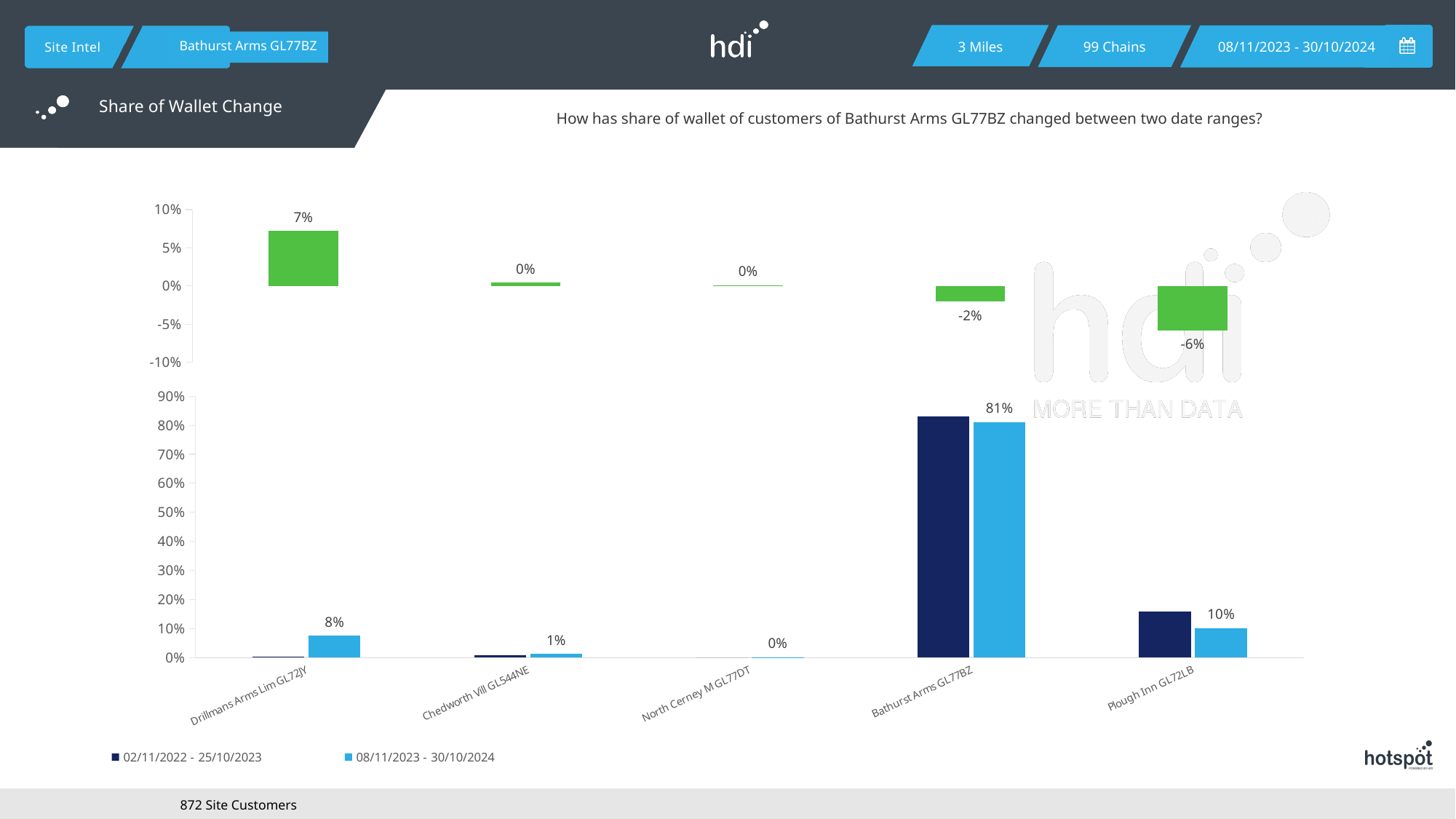
In the bottom chart, which is larger for Plough Inn GL72LB: the 02/11/2022 - 25/10/2023 value or the 08/11/2023 - 30/10/2024 value? 02/11/2022 - 25/10/2023 In the top chart, which site has the highest share of wallet change? Drillmans Arms Lim GL72JY How many series does the legend of the bottom chart list? 2 In the bottom chart, what is the share of wallet for Bathurst Arms GL77BZ in the 08/11/2023 - 30/10/2024 period? 81% In the bottom chart, what is the share of wallet for Plough Inn GL72LB in the 08/11/2023 - 30/10/2024 period? 10% In the top chart, what is the share of wallet change for Plough Inn GL72LB? -6% In the bottom chart, is the 02/11/2022 - 25/10/2023 value for Bathurst Arms GL77BZ greater or less than 80%? greater In the top chart, what is the share of wallet change for Drillmans Arms Lim GL72JY? 7% In the top chart, what is the share of wallet change for Bathurst Arms GL77BZ? -2% How many sites are shown on the x axis of the bottom chart? 5 In the top chart, which site has the lowest share of wallet change? Plough Inn GL72LB In the bottom chart, what is the difference between the 08/11/2023 - 30/10/2024 share of wallet for Bathurst Arms GL77BZ and Plough Inn GL72LB? 71%